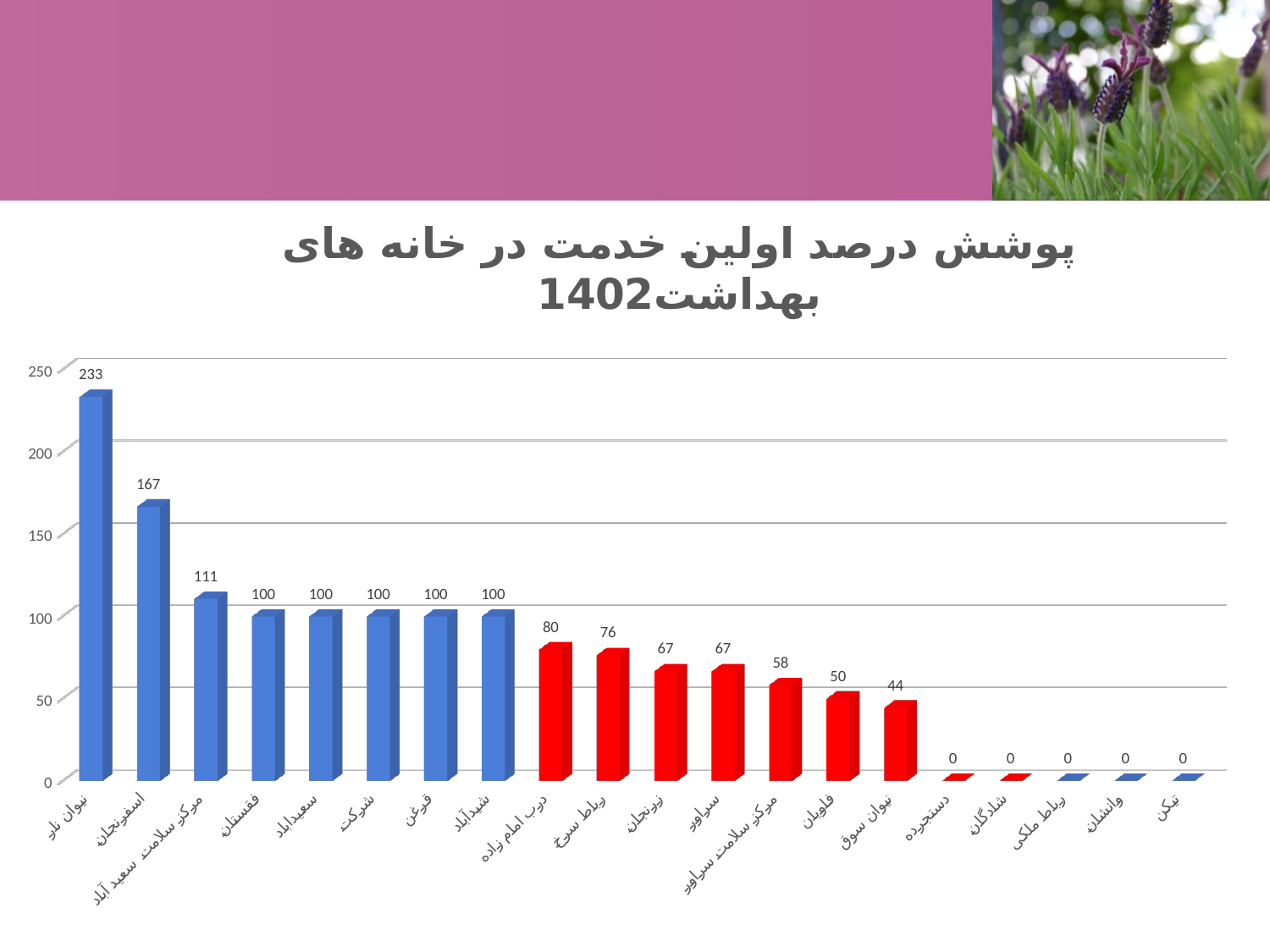
Which has a larger value, فلویان or بیوان سوق? فاویان What is the value for مرکز سلامت سراوند? 58 What is the value for رباط سرخ? 76 What is the value for درب امام زاده? 80 How many categories are shown on the x axis of the chart? 20 What is the value for دستجرده? 0 What type of chart is shown on the slide? bar chart What is the difference between the values for اسفرنجان and مرکز سلامت سعید آباد? 56 What is the value for اسفرنجان? 167 What is the highest value shown in the chart? 233 Do the values generally rise or fall from left to right along the x axis? fall What is the value for مرکز سلامت سعید آباد? 111